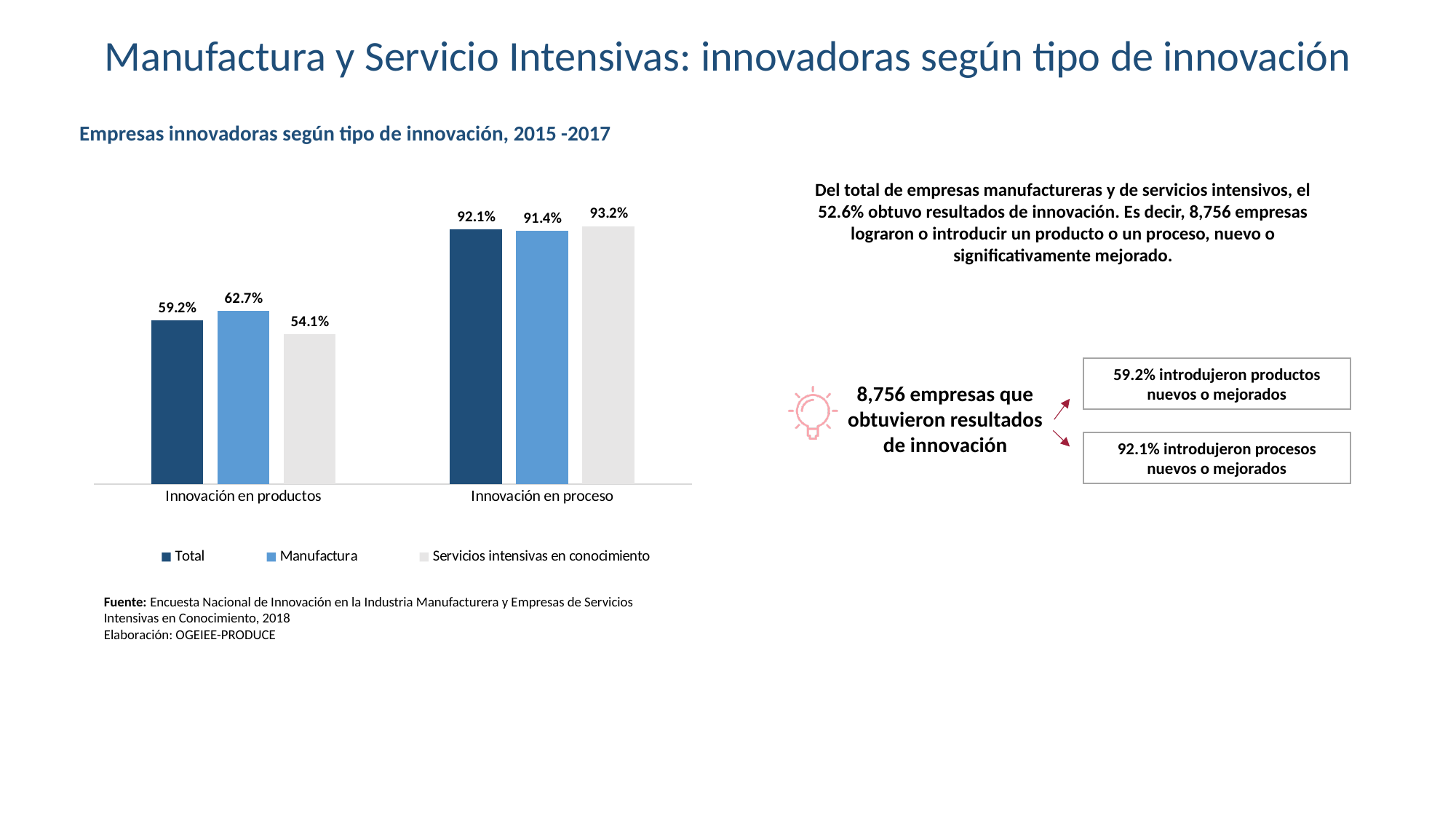
Which series has the highest value in the Innovación en productos category? Manufactura What kind of chart is shown on the slide? Bar chart Which is larger: the Total value for Innovación en productos or the Total value for Innovación en proceso? Innovación en proceso What is the value for Total in the Innovación en proceso category? 92.1% How many series does the legend list? 3 How many categories are shown on the x axis of the chart? 2 Which series has the lowest value in the Innovación en productos category? Servicios intensivas en conocimiento What is the value for Servicios intensivas en conocimiento in the Innovación en proceso category? 93.2% What is the title of the chart? Empresas innovadoras según tipo de innovación, 2015 -2017 What is the difference between the Manufactura and Servicios intensivas en conocimiento values in the Innovación en productos category? 8.6% What is the difference between the Total values for Innovación en proceso and Innovación en productos? 32.9% What is the value for Manufactura in the Innovación en productos category? 62.7%